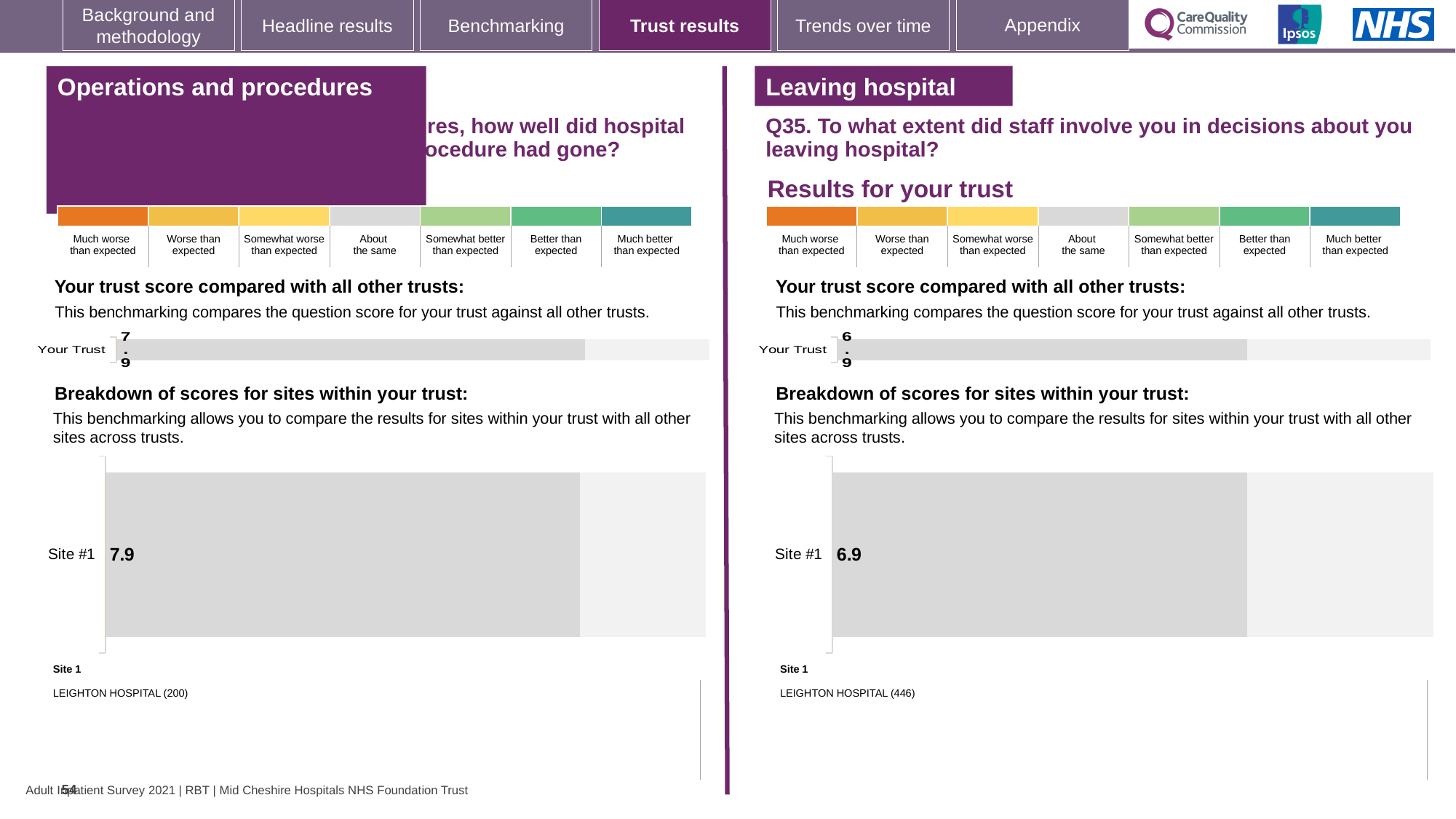
How many sites are shown in the Operations and procedures breakdown chart? 1 On the Leaving hospital breakdown chart, what is the score for Site #1? 6.9 On the Leaving hospital chart, what is the score shown for Your Trust? 6.9 What kind of chart is used to show the Site #1 score on the Leaving hospital side? Bar chart On the Leaving hospital side, which hospital is listed as Site 1? LEIGHTON HOSPITAL (446) How many sites are shown in the Leaving hospital breakdown chart? 1 On the Operations and procedures side, which hospital is listed as Site 1? LEIGHTON HOSPITAL (200) Which section has the higher Your Trust score, Operations and procedures or Leaving hospital? Operations and procedures What is the difference between the Site #1 score on the Operations and procedures chart and the Site #1 score on the Leaving hospital chart? 1.0 On the Operations and procedures chart, what is the score shown for Your Trust? 7.9 Which section has the higher Site #1 score, Operations and procedures or Leaving hospital? Operations and procedures On the Operations and procedures breakdown chart, what is the score for Site #1? 7.9